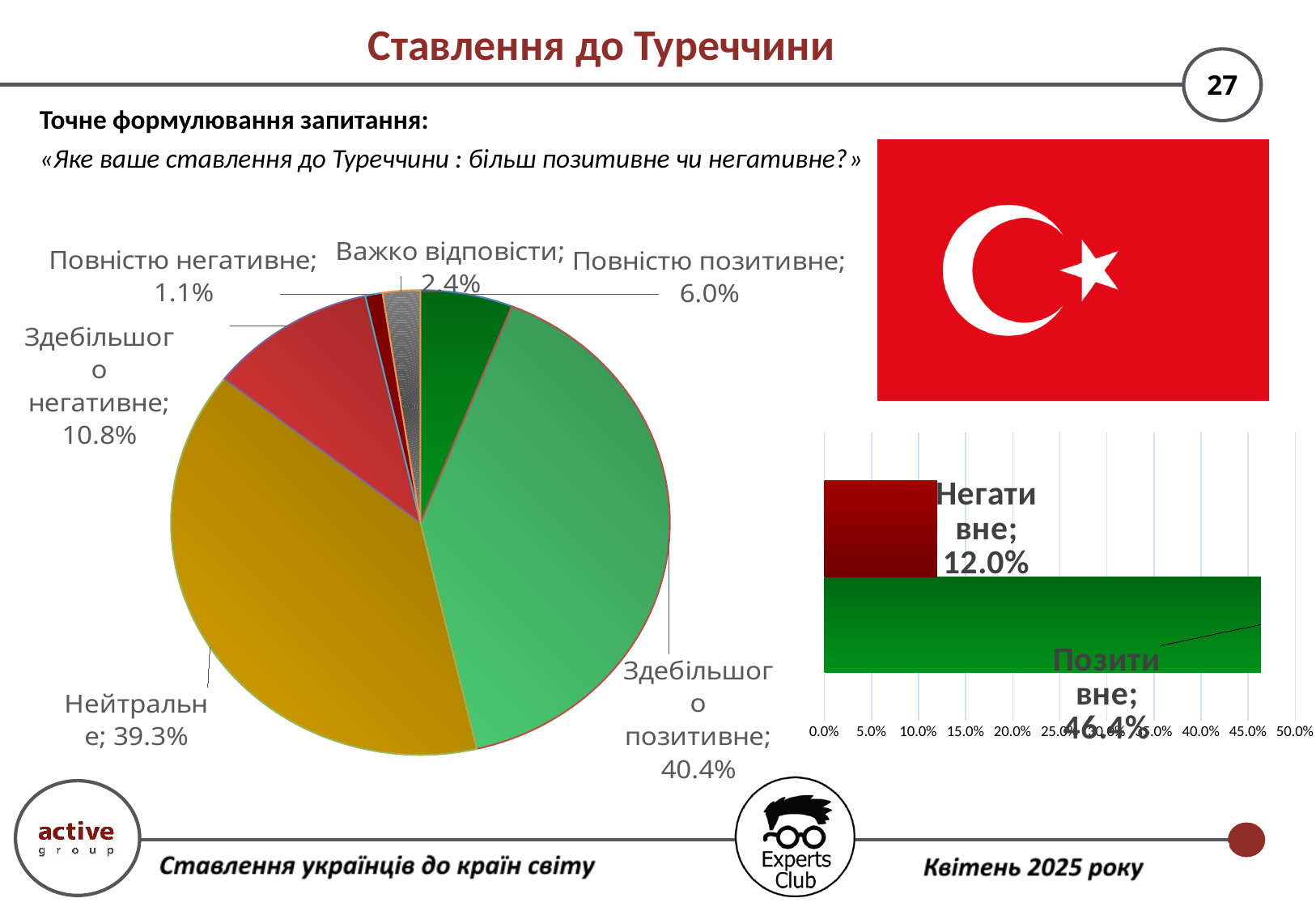
In the pie chart, which is larger: Повністю позитивне or Здебільшого негативне? Здебільшого негативне In the pie chart, what is the value for Здебільшого позитивне? 40.4% In the pie chart, what is the value for Нейтральне? 39.3% In the bar chart on the right, what is the value for Позитивне? 46.4% In the bar chart on the right, what is the value for Негативне? 12.0% What type of chart is shown on the right side of the slide? Bar chart In the pie chart, what is the difference between Здебільшого позитивне and Нейтральне? 1.1% How many categories does the pie chart show? 6 In the bar chart on the right, what is the difference between Позитивне and Негативне? 34.4% In the pie chart, what is the value for Важко відповісти? 2.4% In the pie chart, what is the value for Повністю негативне? 1.1% In the pie chart, which category has the smallest share? Повністю негативне